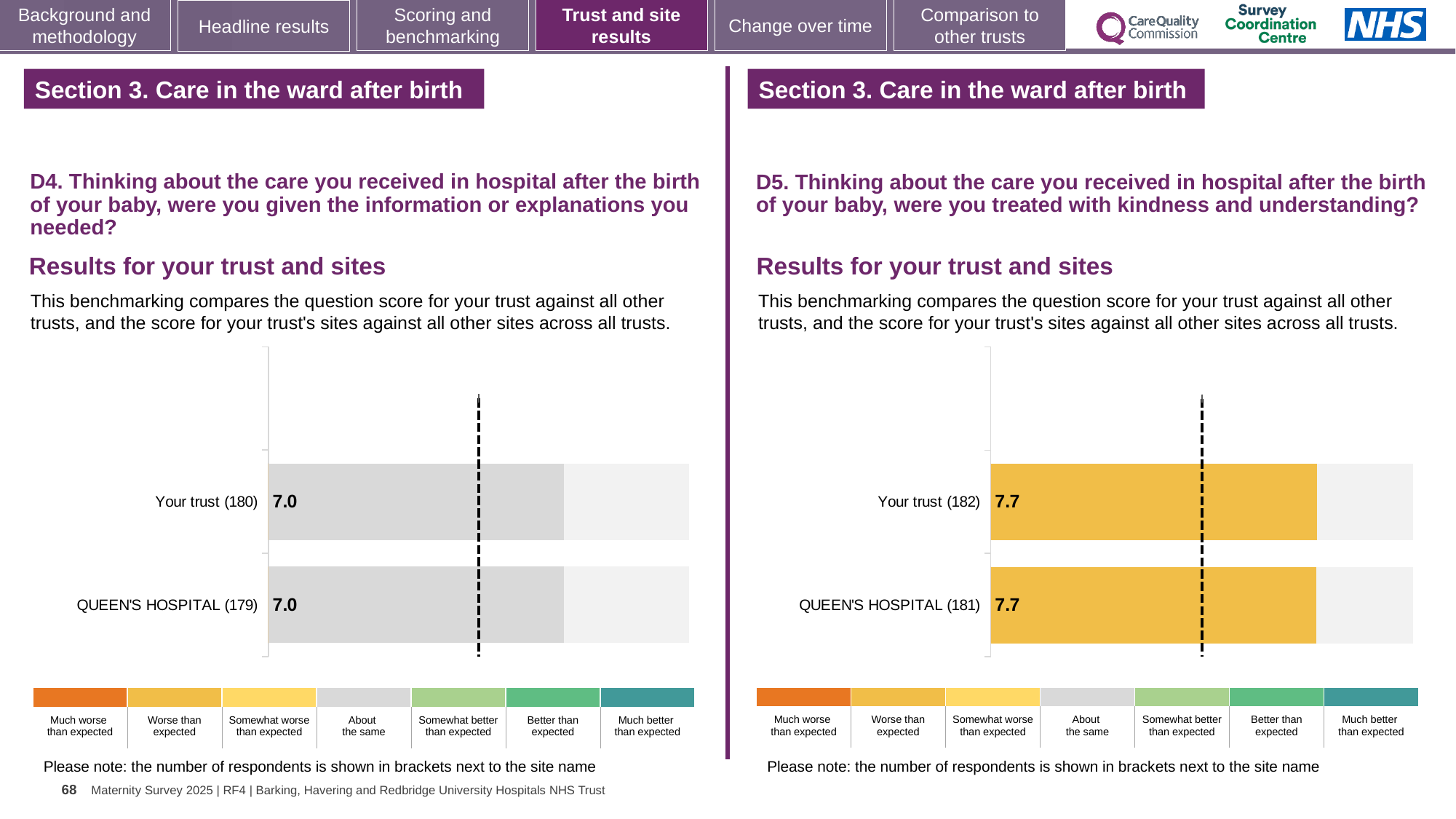
In the D4 chart on the left, what is the score for QUEEN'S HOSPITAL? 7.0 In the D4 chart on the left, what is the difference between the score for Your trust and the score for QUEEN'S HOSPITAL? 0.0 According to the colour key, which benchmark category do the bars in the D4 chart on the left fall into? About the same How many bars are plotted in the D4 chart on the left? 2 In the D5 chart on the right, what is the score for Your trust? 7.7 What type of chart is used for the D5 results on the right? Bar chart In the D4 chart on the left, what is the score for Your trust? 7.0 In the D5 chart on the right, what is the difference between the score for Your trust and the score for QUEEN'S HOSPITAL? 0.0 How many bars are plotted in the D5 chart on the right? 2 In the D4 chart on the left, how many respondents are shown in brackets for Your trust? 180 In the D5 chart on the right, how many respondents are shown in brackets for QUEEN'S HOSPITAL? 181 In the D5 chart on the right, what is the score for QUEEN'S HOSPITAL? 7.7